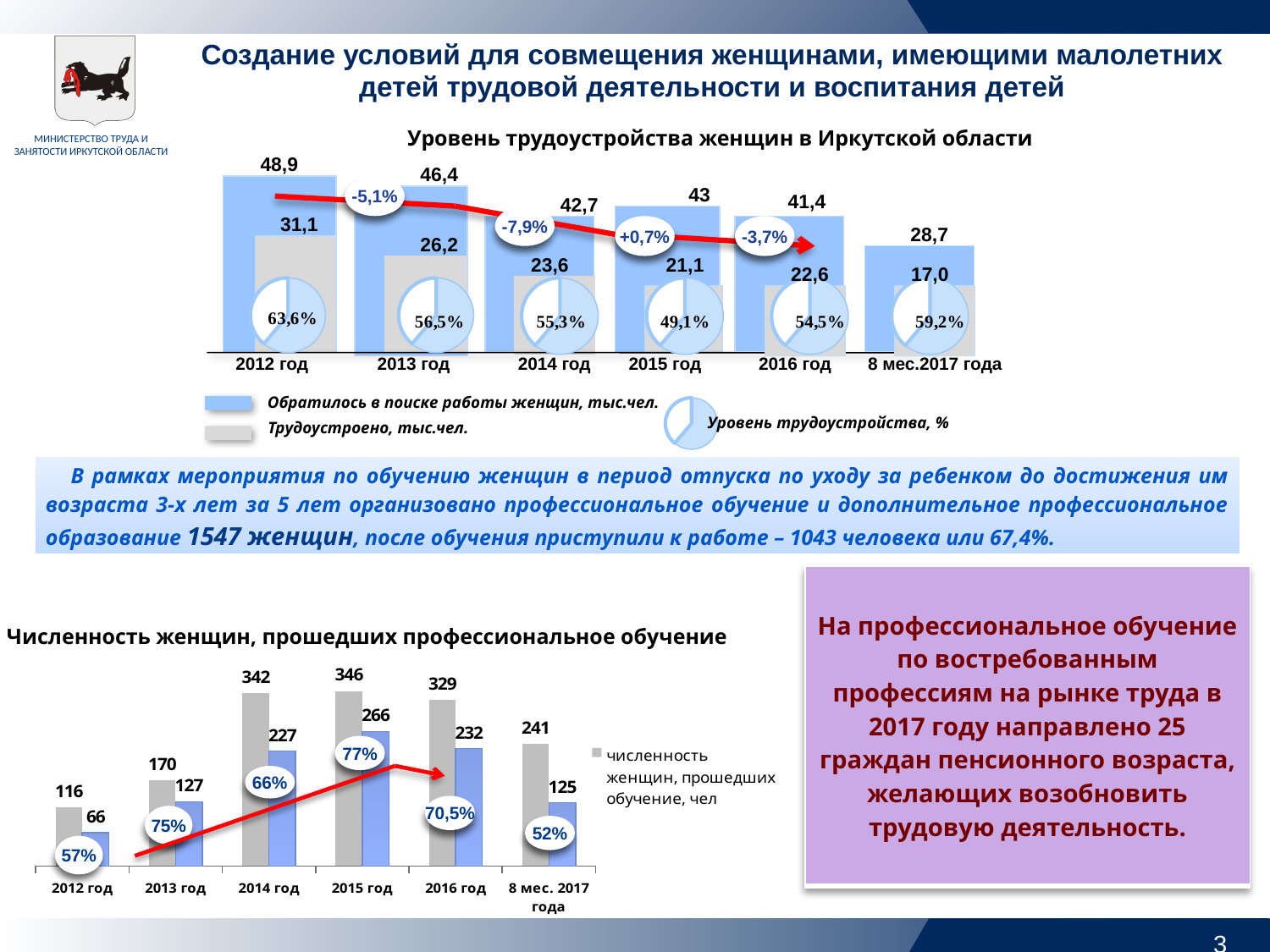
In the chart 'Численность женщин, прошедших профессиональное обучение', what percentage is shown for 2015 год? 77% In the chart 'Численность женщин, прошедших профессиональное обучение', which year has the lowest number of women who completed training? 2012 год In the chart 'Уровень трудоустройства женщин в Иркутской области', what percentage change is shown on the red line between 2013 год and 2014 год? -7,9% In the chart 'Уровень трудоустройства женщин в Иркутской области', how many women applied for work (Обратилось в поиске работы) in 2012 год? 48,9 In the chart 'Уровень трудоустройства женщин в Иркутской области', what is the 'Уровень трудоустройства, %' for 2016 год? 54,5% In the chart 'Уровень трудоустройства женщин в Иркутской области', what is the value of 'Трудоустроено, тыс.чел.' for 2015 год? 21,1 In the chart 'Уровень трудоустройства женщин в Иркутской области', which year has the highest 'Уровень трудоустройства, %'? 2012 год In the chart 'Численность женщин, прошедших профессиональное обучение', how many women completed training in 2015 год? 346 In the chart 'Уровень трудоустройства женщин в Иркутской области', which period has the lowest number of women who applied for work? 8 мес.2017 года In the chart 'Численность женщин, прошедших профессиональное обучение', what is the value of the blue bar for 2016 год? 232 In the chart 'Уровень трудоустройства женщин в Иркутской области', what is the difference between the number of women who applied for work and the number employed in 2013 год? 20,2 What type of chart is 'Численность женщин, прошедших профессиональное обучение'? Bar chart